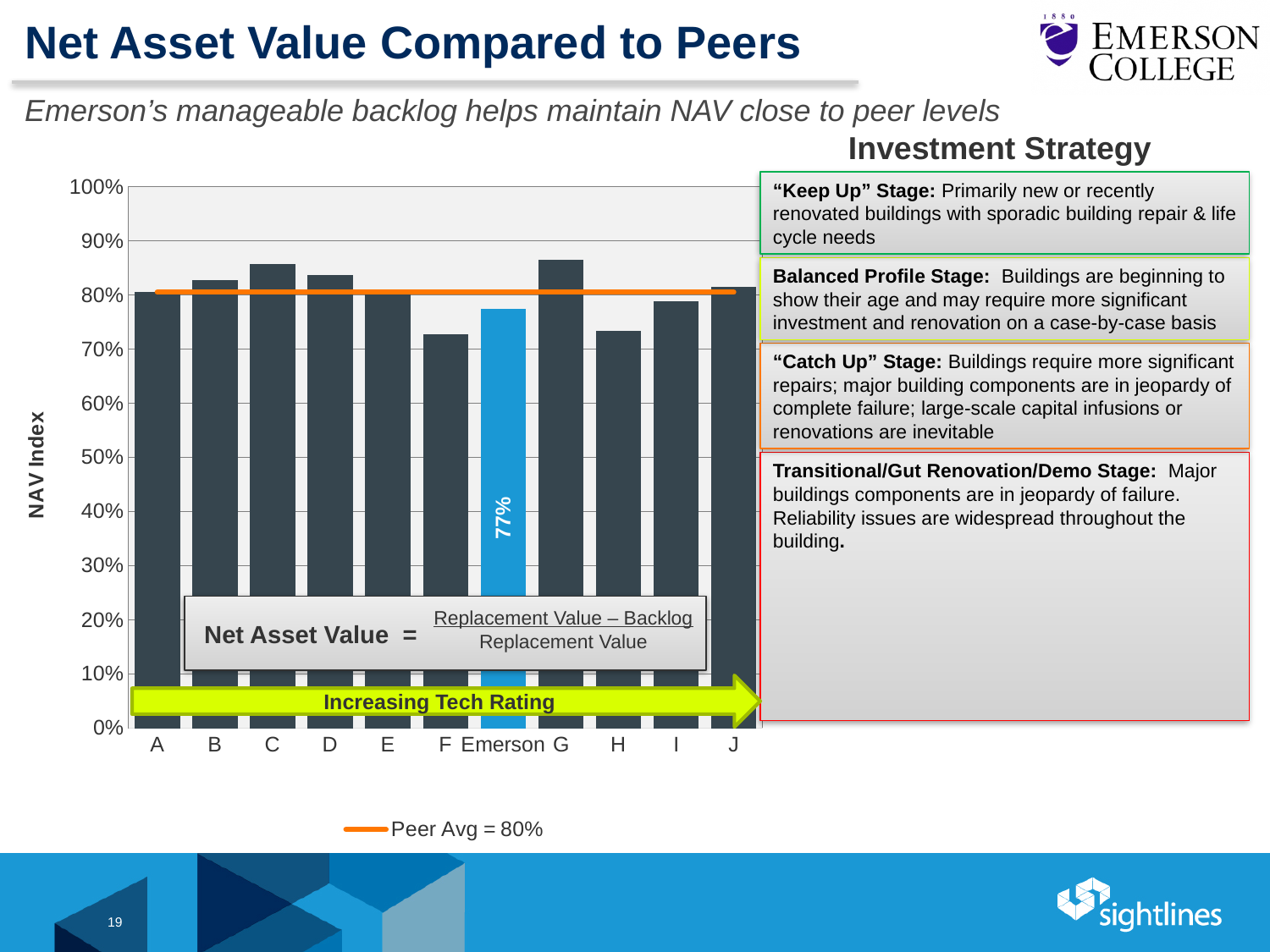
Is the value for G greater or less than 80%? greater How many institutions (bars) are shown on the x axis of the chart? 11 What is the label on the chart's vertical axis? NAV Index Is the value for H greater or less than 80%? less What is the Peer Avg value indicated by the orange line? 80% Is the value for C greater or less than 80%? greater What is the NAV Index value shown for Emerson? 77% Which has a higher NAV Index, Emerson or G? G What kind of chart is used to show the NAV Index by institution? bar chart What does the arrow along the bottom of the chart say? Increasing Tech Rating Which has a higher NAV Index, C or F? C